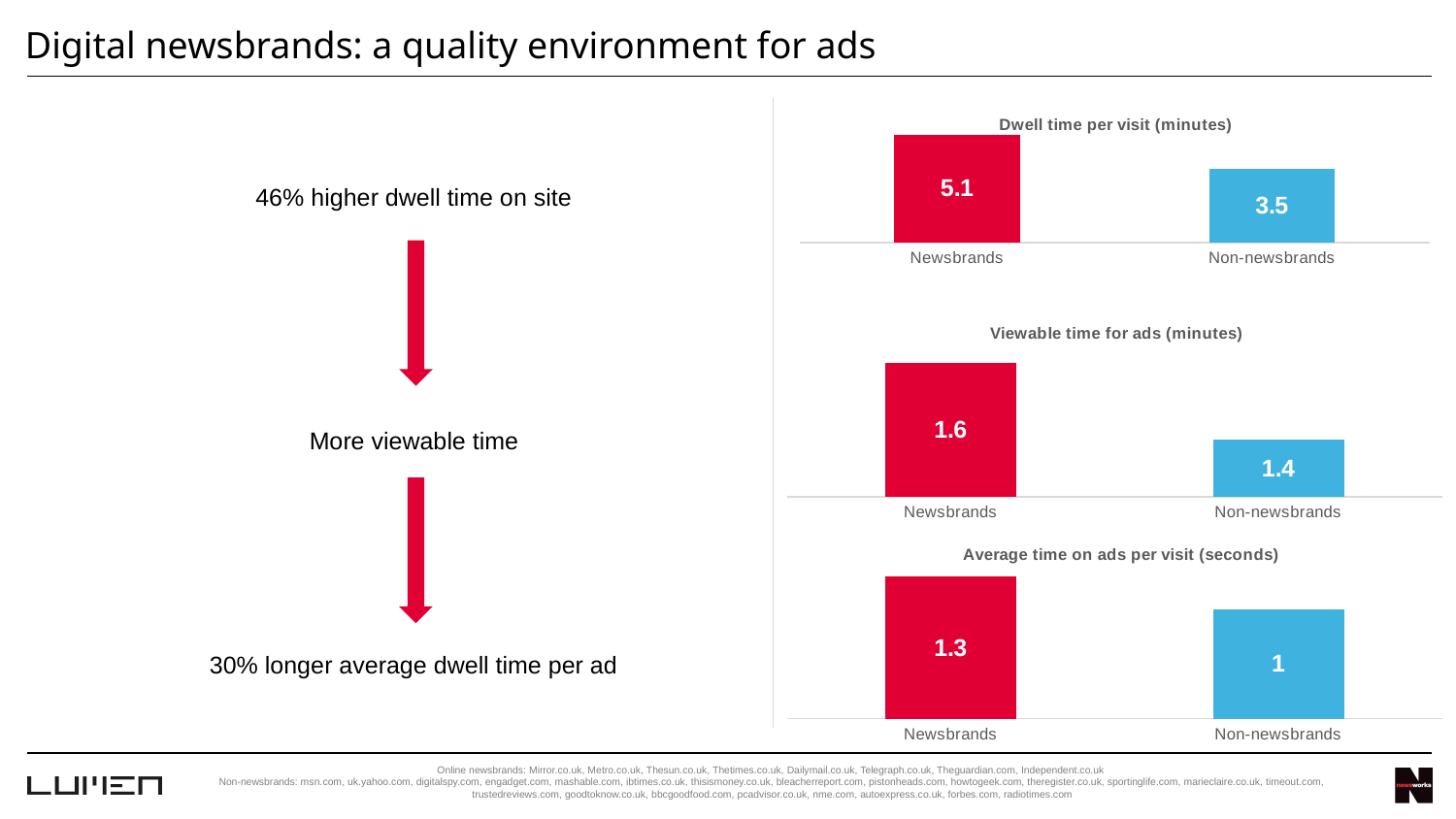
In the 'Dwell time per visit (minutes)' chart, which category has the lowest value? Non-newsbrands In the 'Viewable time for ads (minutes)' chart, what is the value for Non-newsbrands? 1.4 In the 'Dwell time per visit (minutes)' chart, what is the difference between Newsbrands and Non-newsbrands? 1.6 In the 'Average time on ads per visit (seconds)' chart, what is the value for Non-newsbrands? 1 In the 'Average time on ads per visit (seconds)' chart, what is the difference between Newsbrands and Non-newsbrands? 0.3 What type of chart is the 'Viewable time for ads (minutes)' chart? Bar chart How many categories are shown in the 'Average time on ads per visit (seconds)' chart? 2 In the 'Dwell time per visit (minutes)' chart, what is the value for Newsbrands? 5.1 In the 'Average time on ads per visit (seconds)' chart, what is the value for Newsbrands? 1.3 In the 'Viewable time for ads (minutes)' chart, which category has the higher value? Newsbrands In the 'Dwell time per visit (minutes)' chart, what is the value for Non-newsbrands? 3.5 In the 'Viewable time for ads (minutes)' chart, what is the value for Newsbrands? 1.6